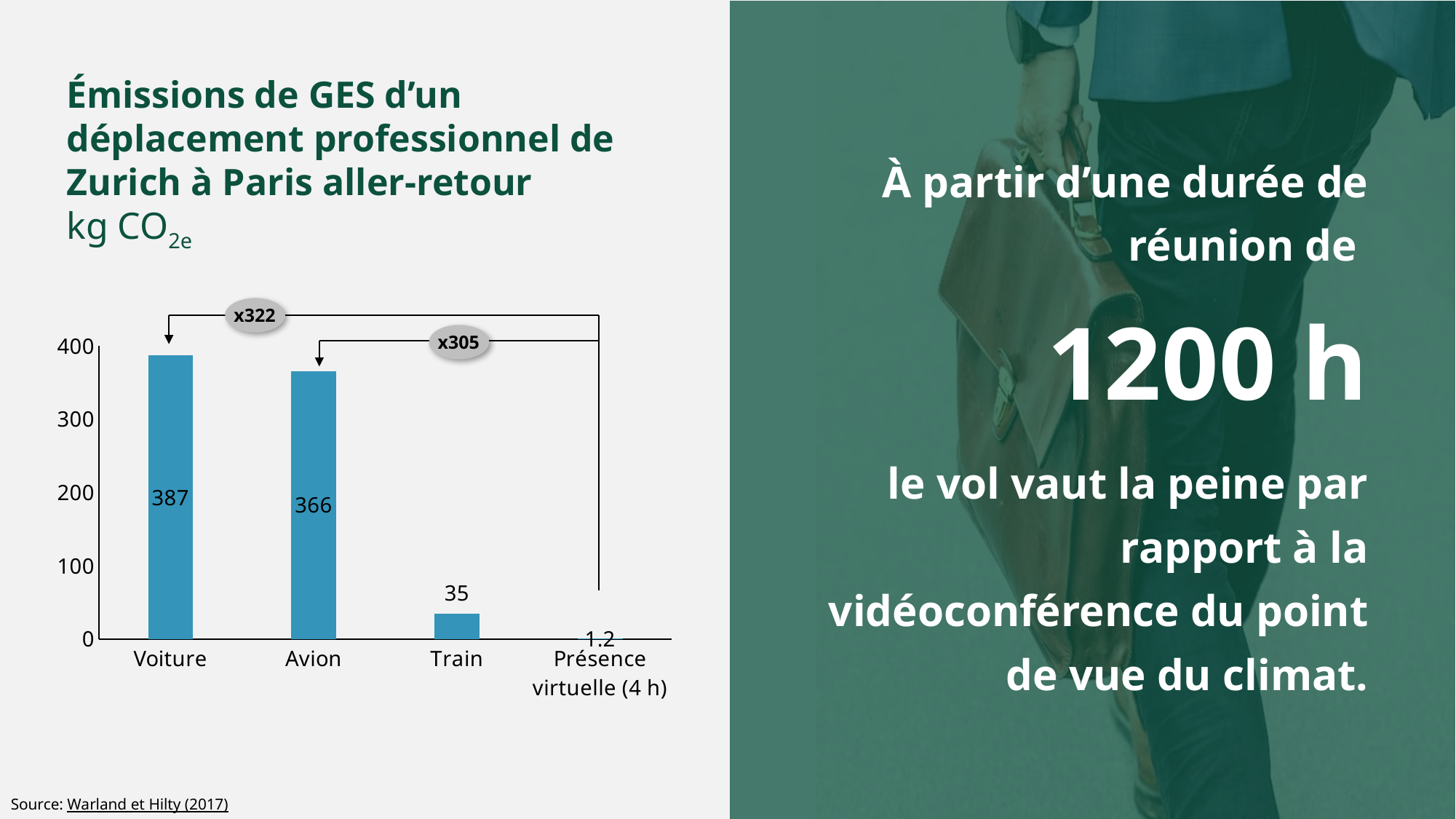
Which category has the lowest emissions? Présence virtuelle (4 h) What kind of chart is shown? Bar chart How many categories are shown on the x axis? 4 Which category has the highest emissions? Voiture What is the difference between the values for Avion and Train? 331 What is the value for Avion? 366 Which is larger, the value for Train or the value for Avion? Avion What is the value for Train? 35 What is the value for Voiture? 387 What unit is given under the chart title? kg CO2e What is the value for Présence virtuelle (4 h)? 1.2 What is the difference between the values for Voiture and Avion? 21